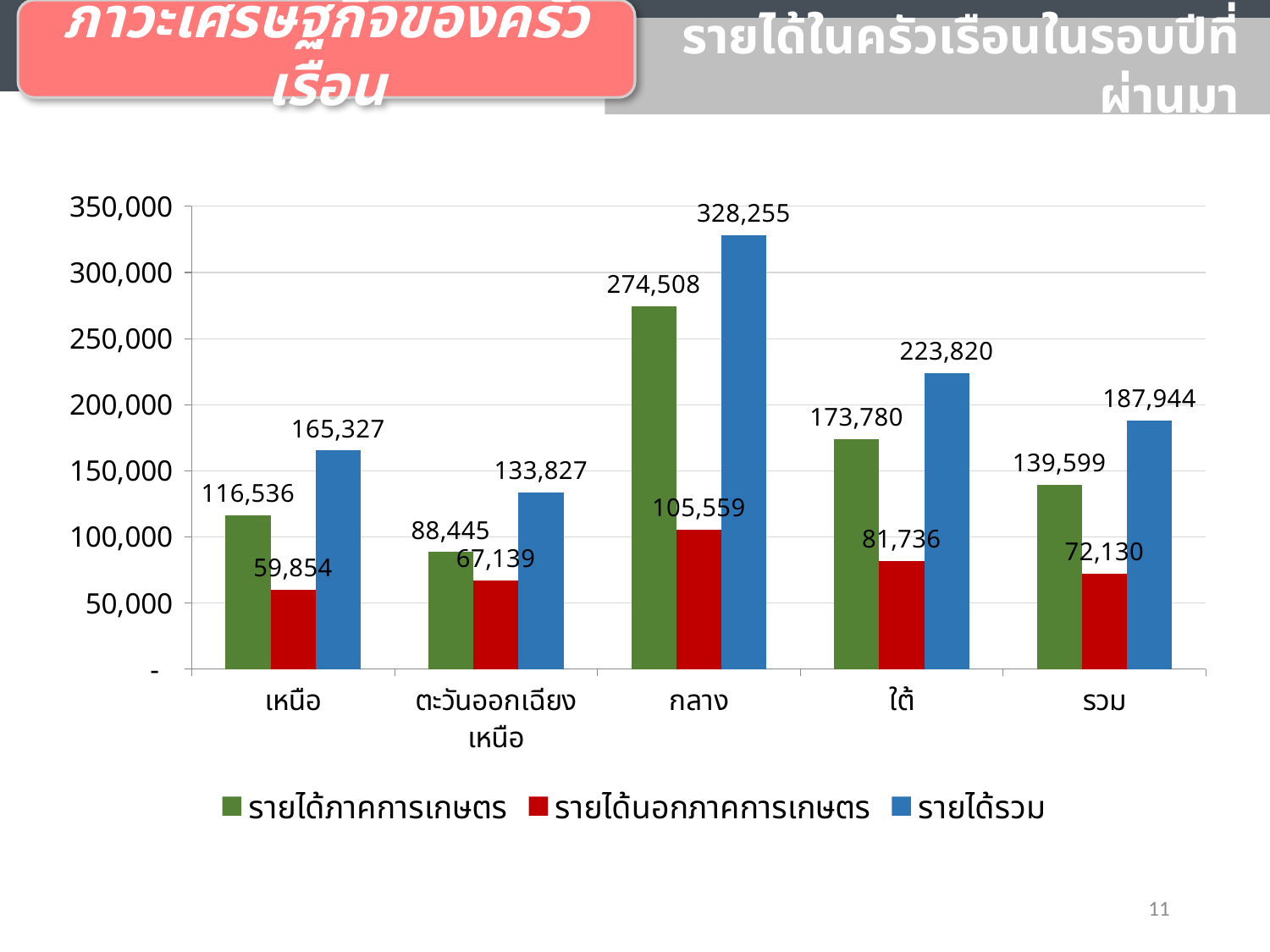
How many series does the legend list? 3 Is the value of รายได้รวม for ตะวันออกเฉียงเหนือ greater or less than 150,000? less Which is larger: รายได้นอกภาคการเกษตร for กลาง or for ใต้? กลาง Which category has the highest value for รายได้รวม? กลาง How many categories are shown on the x axis? 5 What is the value of รายได้นอกภาคการเกษตร for เหนือ? 59,854 What kind of chart is shown on the slide? bar chart What is the value of รายได้ภาคการเกษตร for ใต้? 173,780 What is the value of รายได้รวม for กลาง? 328,255 Which category has the lowest value for รายได้นอกภาคการเกษตร? เหนือ What is the difference between รายได้รวม and รายได้ภาคการเกษตร for รวม? 48,345 What is the value of รายได้ภาคการเกษตร for ตะวันออกเฉียงเหนือ? 88,445